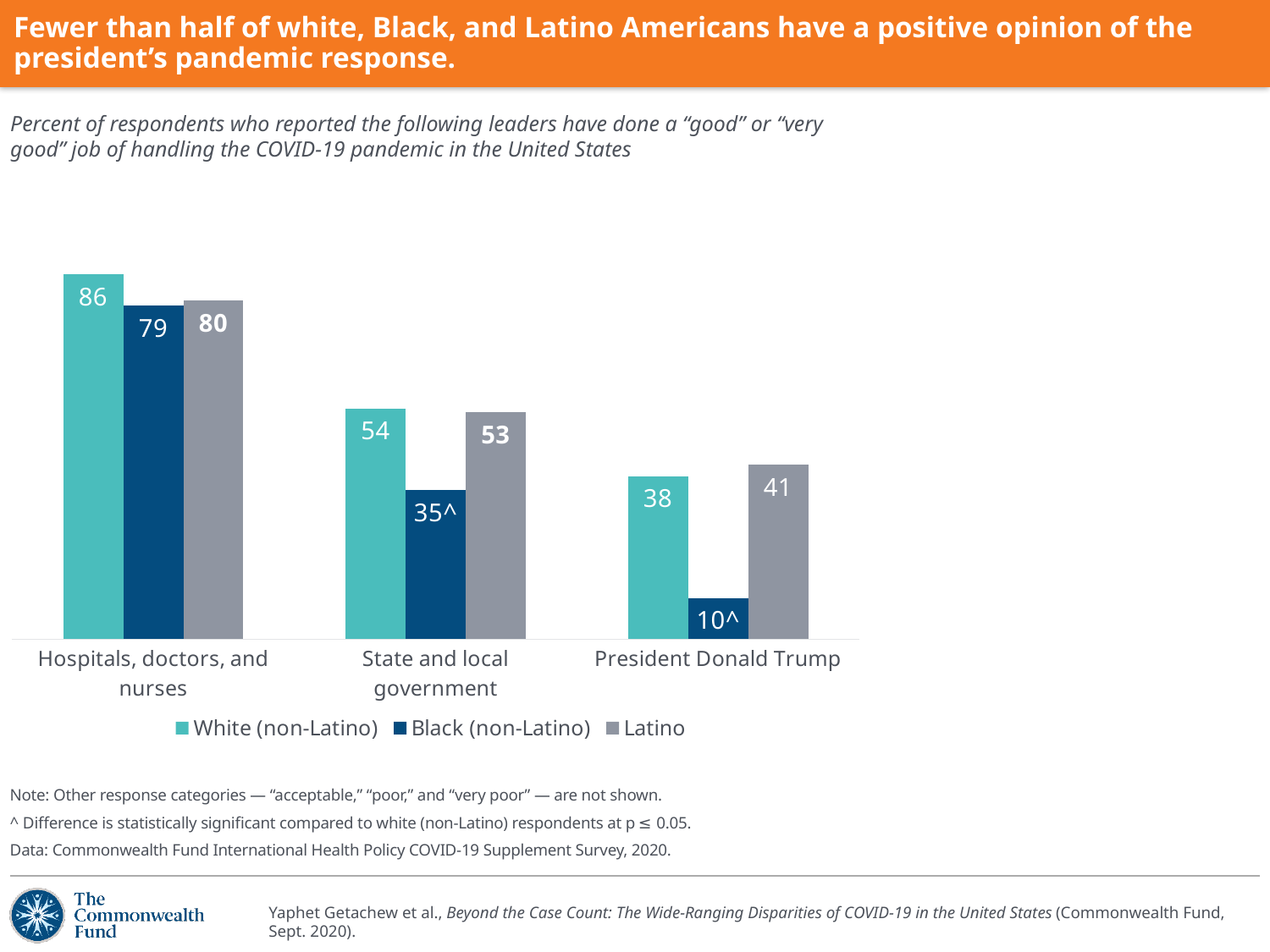
For President Donald Trump, which is larger: the White (non-Latino) value or the Latino value? Latino How many leader categories are shown on the x axis? 3 What is the value for Latino respondents for state and local government? 53 What is the difference between the White (non-Latino) and Latino values for hospitals, doctors, and nurses? 6 What is the value for Black (non-Latino) respondents for President Donald Trump? 10^ What is the value for Black (non-Latino) respondents for state and local government? 35^ How many series does the legend list? 3 What is the difference between the White (non-Latino) and Black (non-Latino) values for President Donald Trump? 28 What percent of White (non-Latino) respondents said hospitals, doctors, and nurses have done a good or very good job? 86 Which leader category has the lowest value for White (non-Latino) respondents? President Donald Trump What kind of chart is shown on the slide? Bar chart Which leader category has the highest value for Latino respondents? Hospitals, doctors, and nurses